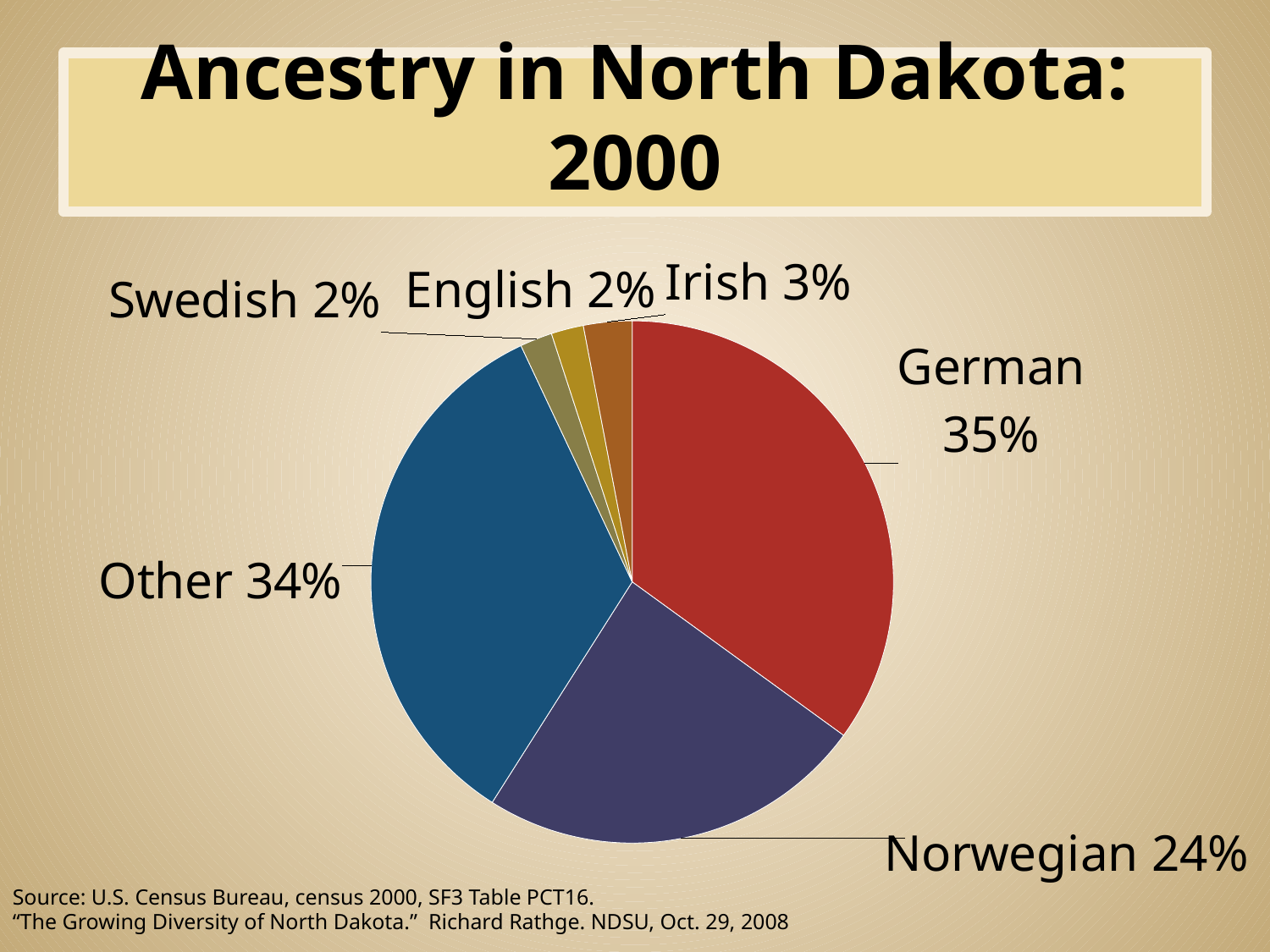
What kind of chart is shown on the slide? pie chart What percentage is shown for Swedish ancestry? 2% What percentage is shown for Irish ancestry? 3% How many slices does the pie chart have? 6 What is the difference in percentage points between the German share and the Norwegian share? 11 What percentage is shown for Norwegian ancestry? 24% Which is larger, the share for Norwegian or the share for Other? Other What share of the pie does German ancestry represent? 35% What is the title of the chart? Ancestry in North Dakota: 2000 Which ancestry category has the largest share of the pie? German What percentage is shown for the Other category? 34% Which is larger, the share for Irish or the share for English? Irish